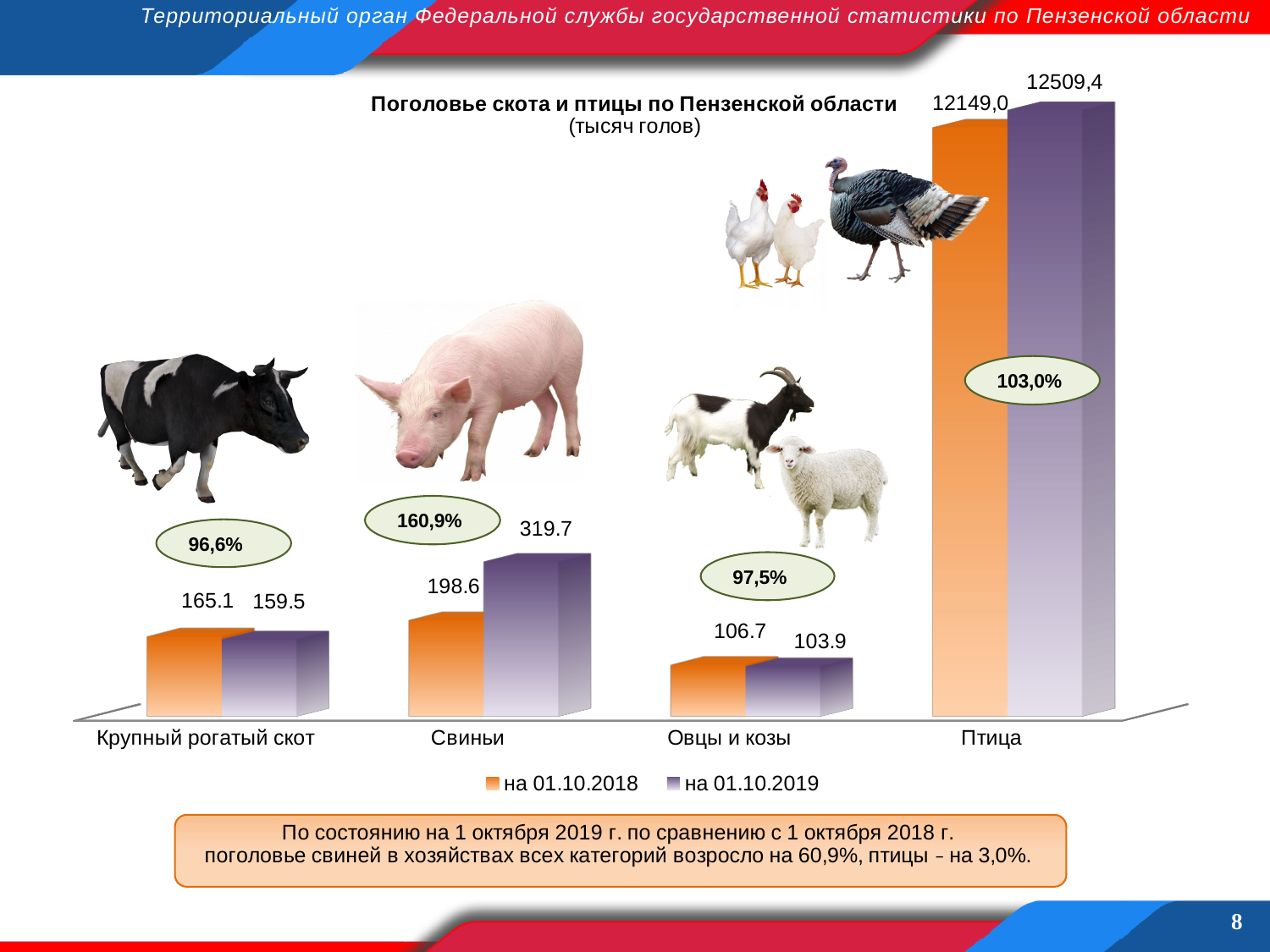
What is the value for Овцы и козы on 01.10.2019? 103.9 Which is larger for Крупный рогатый скот: the value on 01.10.2018 or on 01.10.2019? на 01.10.2018 Which category has the highest value on 01.10.2019? Птица How many series does the legend list? 2 What is the value for Крупный рогатый скот on 01.10.2018? 165.1 What percentage is shown in the oval above the Свиньи bars? 160,9% What type of chart is shown on the slide? bar chart How many categories are shown on the x axis of the chart? 4 What is the difference between the 01.10.2019 and 01.10.2018 values for Свиньи? 121.1 What is the value for Свиньи on 01.10.2019? 319.7 What is the value for Птица on 01.10.2019? 12509,4 Which category has the lowest value on 01.10.2018? Овцы и козы